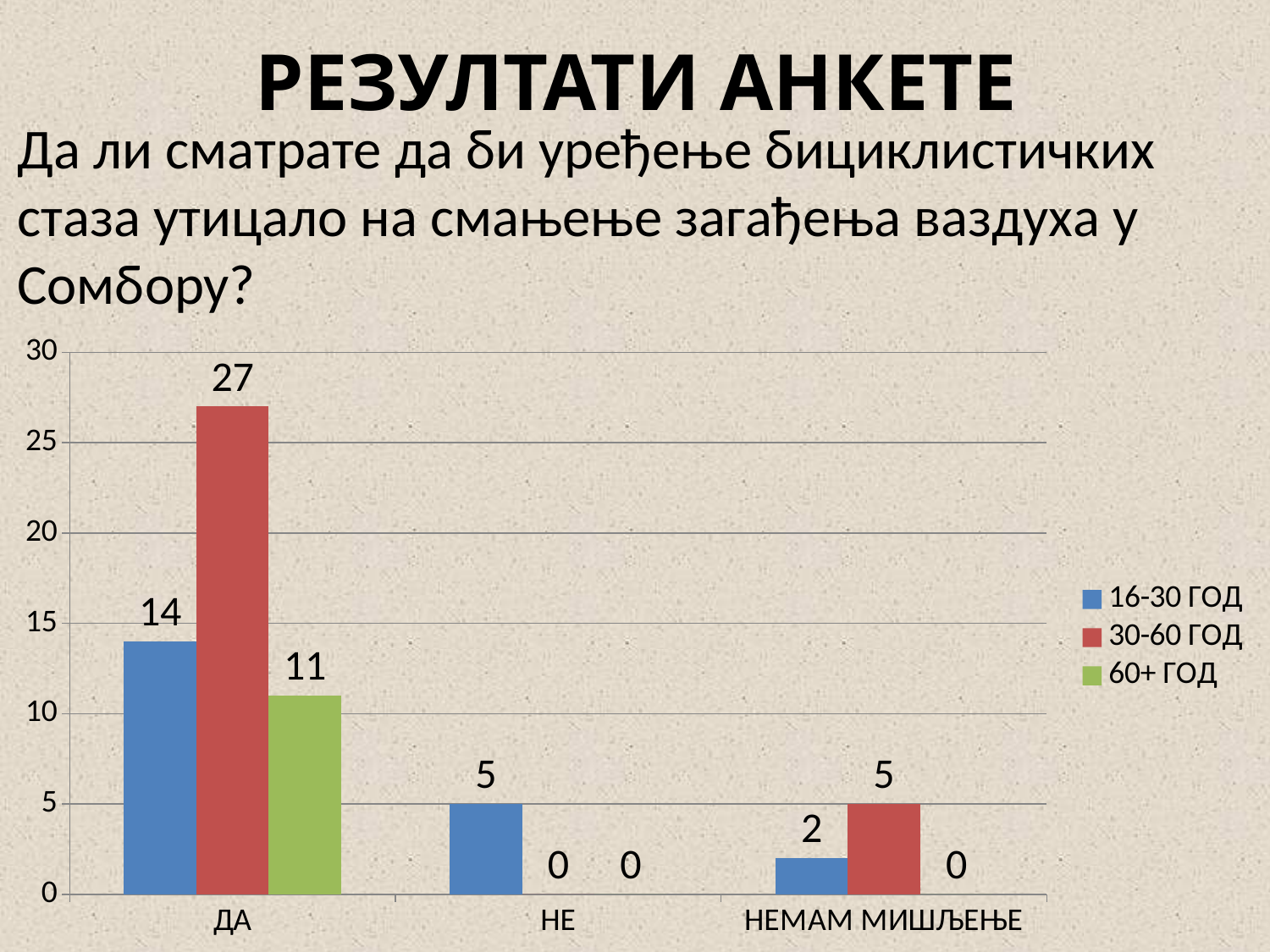
What value does the 30-60 ГОД series have for the ДА category? 27 What kind of chart is shown on the slide? bar chart Which category has the highest value for the 30-60 ГОД series? ДА What is the difference between the 30-60 ГОД and 16-30 ГОД values for the ДА category? 13 How many categories are shown on the x axis? 3 What value does the 60+ ГОД series have for the ДА category? 11 Which series has the lowest value for the ДА category? 60+ ГОД For the НЕМАМ МИШЉЕЊЕ category, which is larger: the 16-30 ГОД value or the 30-60 ГОД value? 30-60 ГОД How many series does the legend list? 3 What value does the 16-30 ГОД series have for the НЕ category? 5 What value does the 16-30 ГОД series have for the НЕМАМ МИШЉЕЊЕ category? 2 What is the total of the three series values for the ДА category? 52